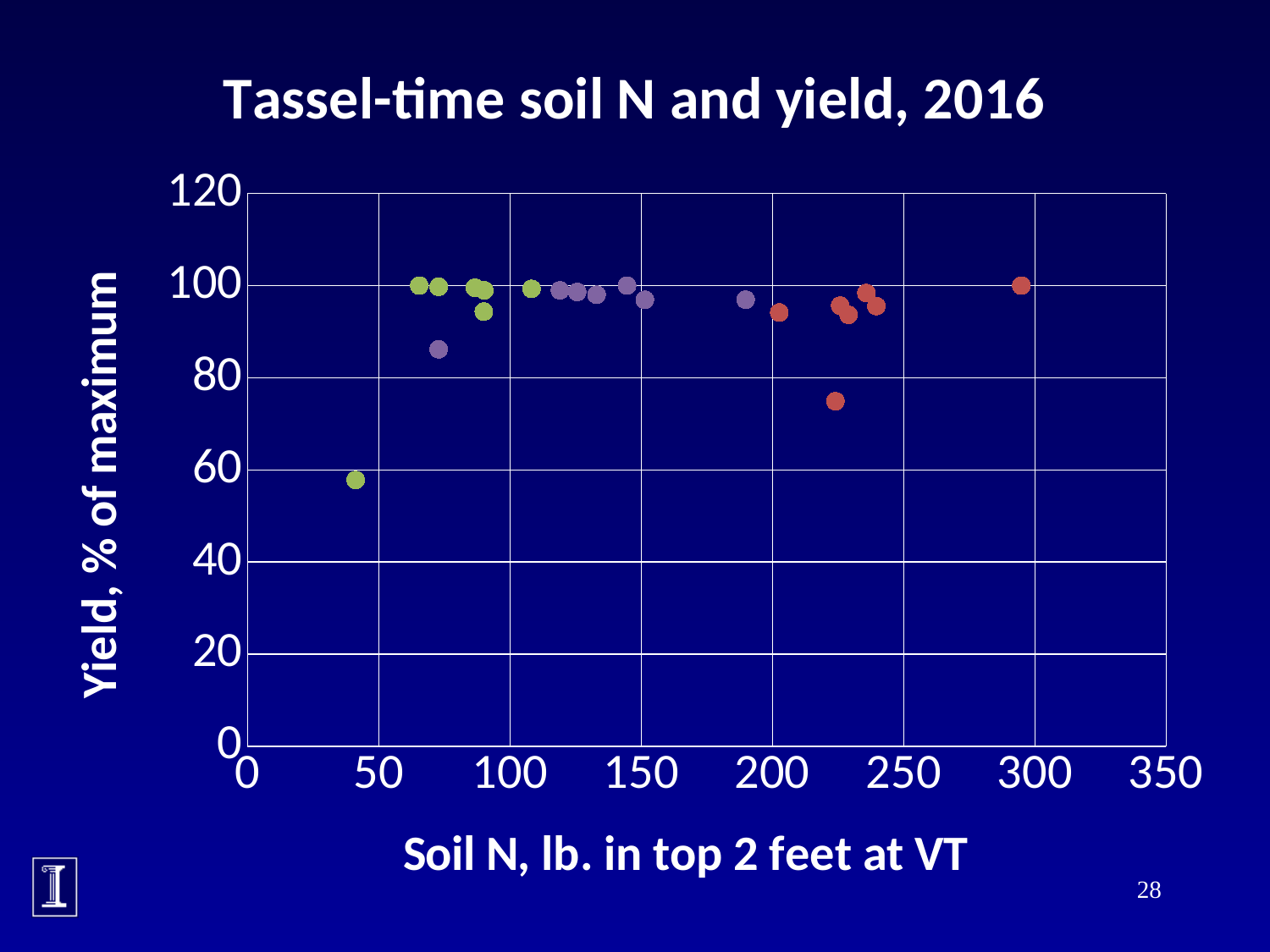
What is the highest value shown on the x axis? 350 What is the title of the chart? Tassel-time soil N and yield, 2016 What is the highest value shown on the y axis? 120 What is the label of the x axis? Soil N, lb. in top 2 feet at VT Is the yield of the lowest point on the chart greater or less than 80? less Do the points with soil N above 100 generally have yields greater or less than 80? greater Is the soil N value of the rightmost point greater or less than 250? greater Which point has the lower yield: the lowest green point or the lowest red point? The lowest green point What kind of chart is shown on the slide? Scatter chart